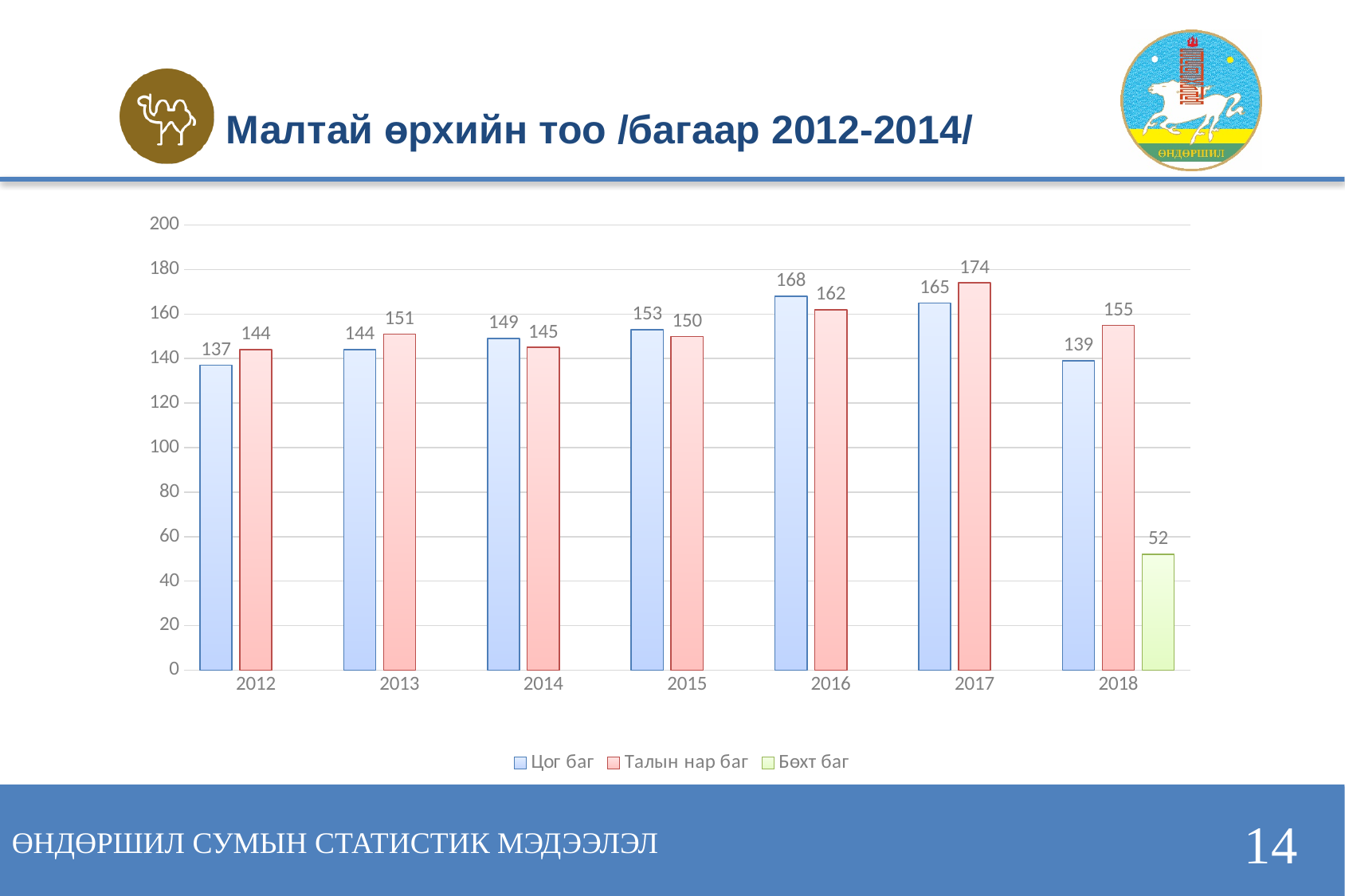
What is the value for Цог баг in 2016? 168 Which is larger in 2014, Цог баг or Талын нар баг? Цог баг How many years are shown on the x axis? 7 What is the difference between Талын нар баг and Цог баг in 2018? 16 In which year is the value for Талын нар баг highest? 2017 In which year is the value for Цог баг lowest? 2012 What kind of chart is shown on the slide? bar chart How many series does the legend list? 3 What colour are the bars for Бөхт баг? green What is the value for Талын нар баг in 2017? 174 Is the value for Цог баг in 2013 greater or less than 160? less What is the value for Бөхт баг in 2018? 52